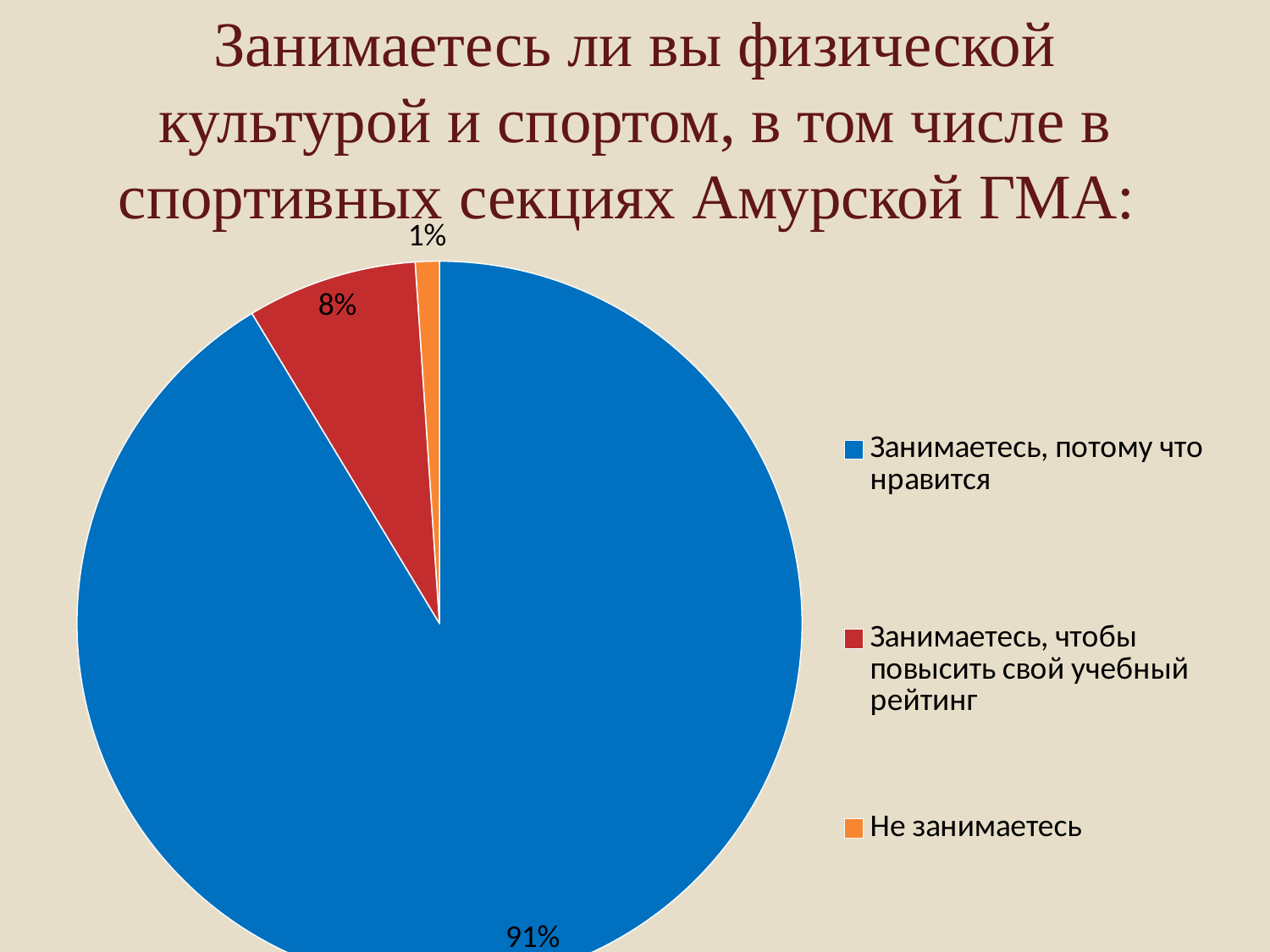
What colour is the slice for "Не занимаетесь"? orange What share of the pie is labelled "Занимаетесь, чтобы повысить свой учебный рейтинг"? 8% What colour is the slice for "Занимаетесь, потому что нравится"? blue What is the difference in percentage points between "Занимаетесь, потому что нравится" and "Занимаетесь, чтобы повысить свой учебный рейтинг"? 83 Which category has the smallest slice of the pie? Не занимаетесь Which is larger: the slice for "Занимаетесь, чтобы повысить свой учебный рейтинг" or the slice for "Не занимаетесь"? Занимаетесь, чтобы повысить свой учебный рейтинг What kind of chart is shown on the slide? pie chart What is the difference in percentage points between "Занимаетесь, чтобы повысить свой учебный рейтинг" and "Не занимаетесь"? 7 What share of the pie is labelled "Не занимаетесь"? 1% Which category has the largest slice of the pie? Занимаетесь, потому что нравится How many categories does the pie chart have? 3 What share of the pie is labelled "Занимаетесь, потому что нравится"? 91%